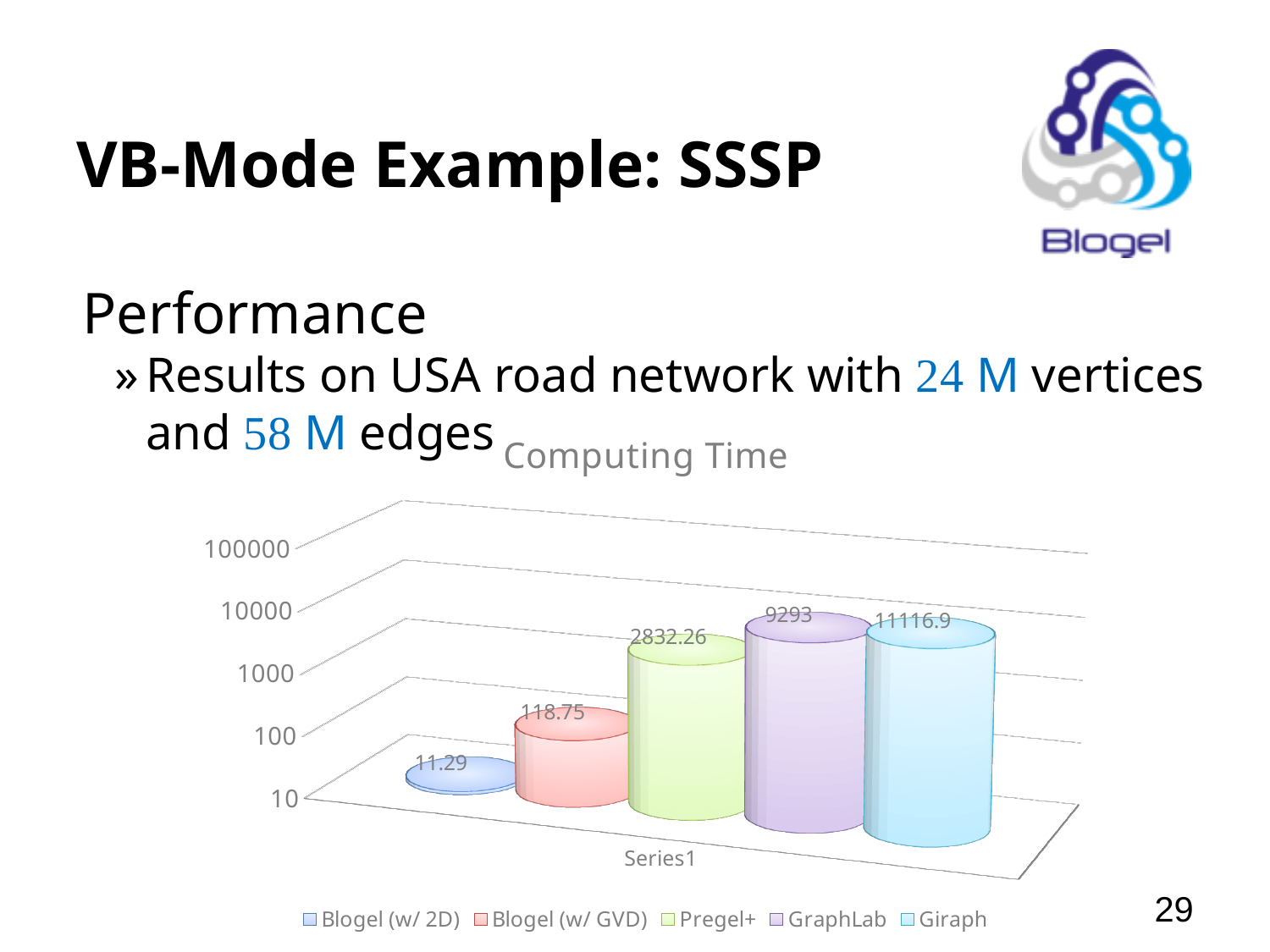
What is the computing time shown for Giraph? 11116.9 What is the computing time shown for Blogel (w/ GVD)? 118.75 Which has a larger computing time, Pregel+ or Blogel (w/ GVD)? Pregel+ What is the computing time shown for Pregel+? 2832.26 What is the difference between the computing times of Giraph and GraphLab? 1823.9 What is the computing time shown for Blogel (w/ 2D)? 11.29 Which system has the highest computing time in the chart? Giraph What is the title of the chart? Computing Time What is the computing time shown for GraphLab? 9293 Which system has the lowest computing time in the chart? Blogel (w/ 2D) How many series does the chart legend list? 5 Is the computing time for Pregel+ greater or less than 1000? greater